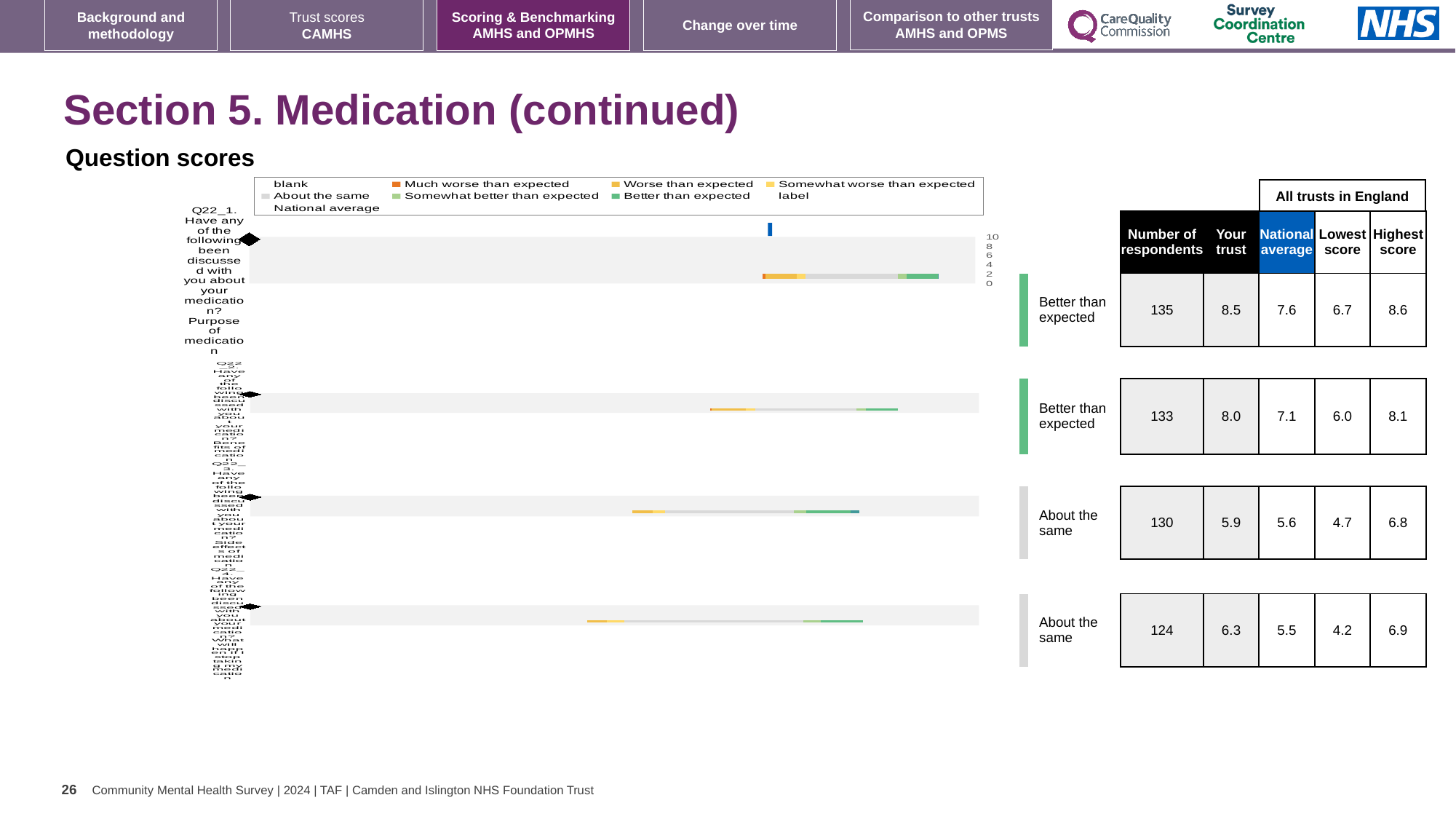
What is the maximum value shown on the chart's score axis? 10 What is the national average score for Q22_2 (Benefits of medication)? 7.1 How many question bars (categories) are plotted in the chart? 4 Is the 'Your trust' score for Q22_4 higher or lower than the national average for Q22_4? higher Which question has the lowest 'Your trust' score? Q22_3 (Side effects of medication) In the chart legend, what colour represents 'Much worse than expected'? orange Which question has the highest 'Your trust' score? Q22_1 (Purpose of medication) What is the 'Your trust' score for Q22_1 (Purpose of medication)? 8.5 What is the difference between the 'Your trust' score and the national average for Q22_1? 0.9 What kind of chart is shown under 'Question scores'? bar chart How is the trust's result for Q22_3 (Side effects of medication) categorised relative to expectation? About the same What is the 'Your trust' score for Q22_3 (Side effects of medication)? 5.9